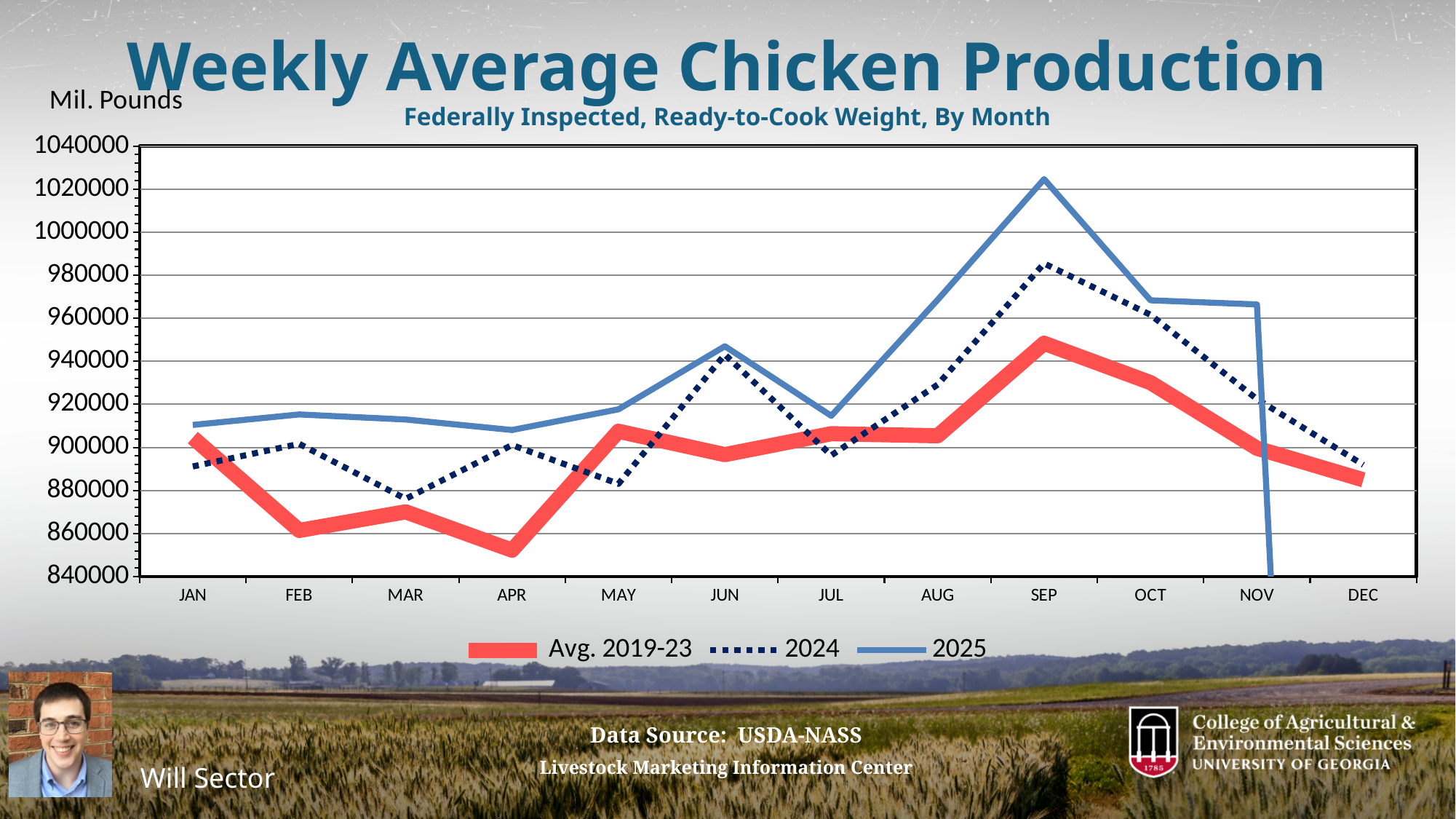
In which month does the 2025 series reach its highest value? SEP Does the Avg. 2019-23 series rise or fall from JAN to APR? fall What unit label is shown above the y axis? Mil. Pounds Which is larger in FEB, the 2025 value or the Avg. 2019-23 value? 2025 What kind of chart is shown on the slide? line chart Is the value for 2024 in SEP greater or less than 960000? greater Is the value for Avg. 2019-23 in APR greater or less than 860000? less How many months are shown along the x axis? 12 In which month does the Avg. 2019-23 series reach its lowest value? APR In which month does the 2024 series reach its highest value? SEP How many series does the legend list? 3 Is the value for 2025 in SEP greater or less than 1000000? greater